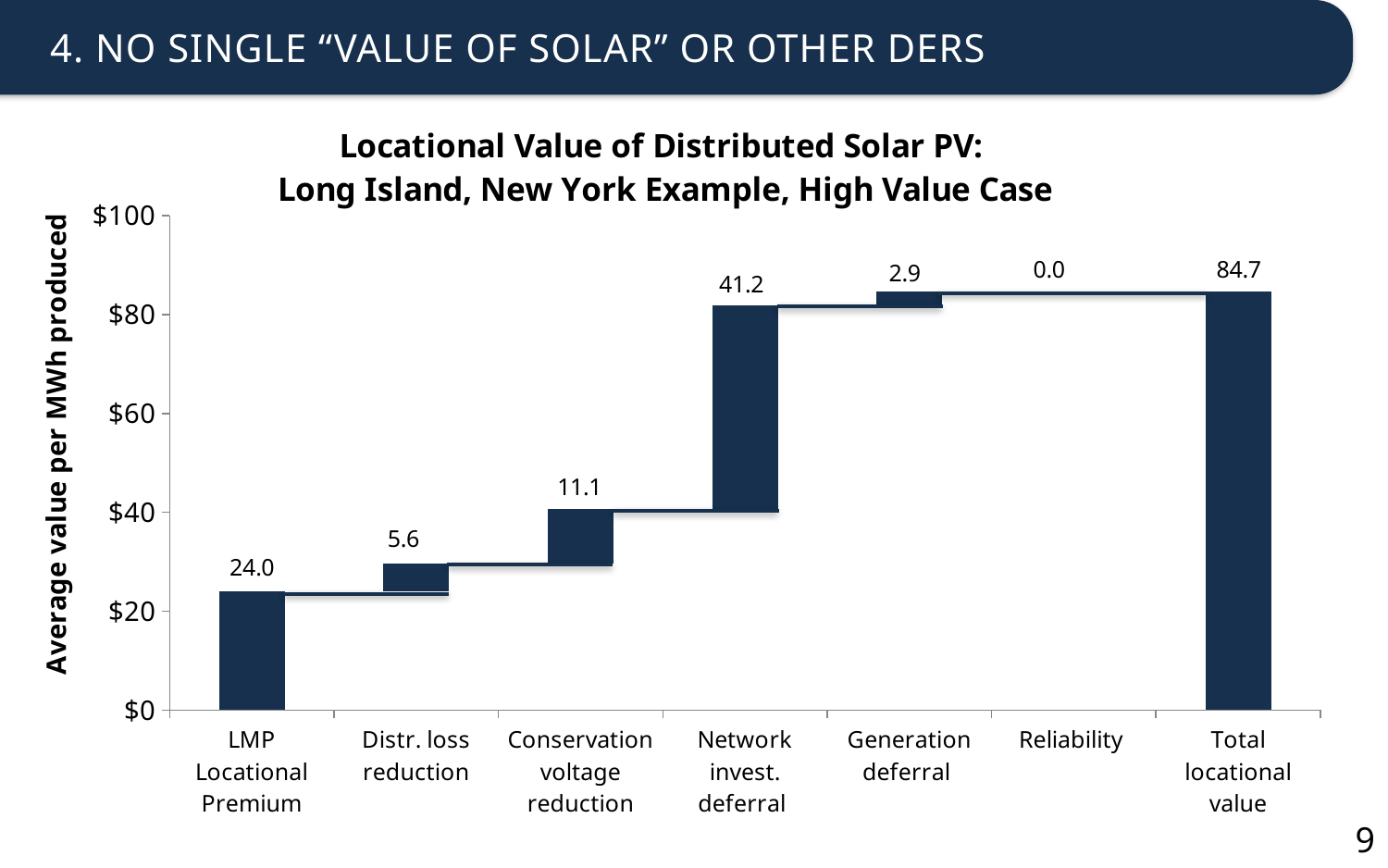
What is the difference between the values for LMP Locational Premium and Distr. loss reduction? 18.4 Excluding the Total locational value bar, which category has the highest value? Network invest. deferral Is the value for Total locational value greater or less than $80? greater What is the value for Total locational value? 84.7 What is the value for Network invest. deferral? 41.2 What is the label of the vertical axis? Average value per MWh produced What is the value for Reliability? 0.0 How many categories are shown on the x axis? 7 What is the value for LMP Locational Premium? 24.0 Which category has the lowest value? Reliability What is the difference between the values for Network invest. deferral and Conservation voltage reduction? 30.1 Which is larger, the value for Distr. loss reduction or the value for Generation deferral? Distr. loss reduction